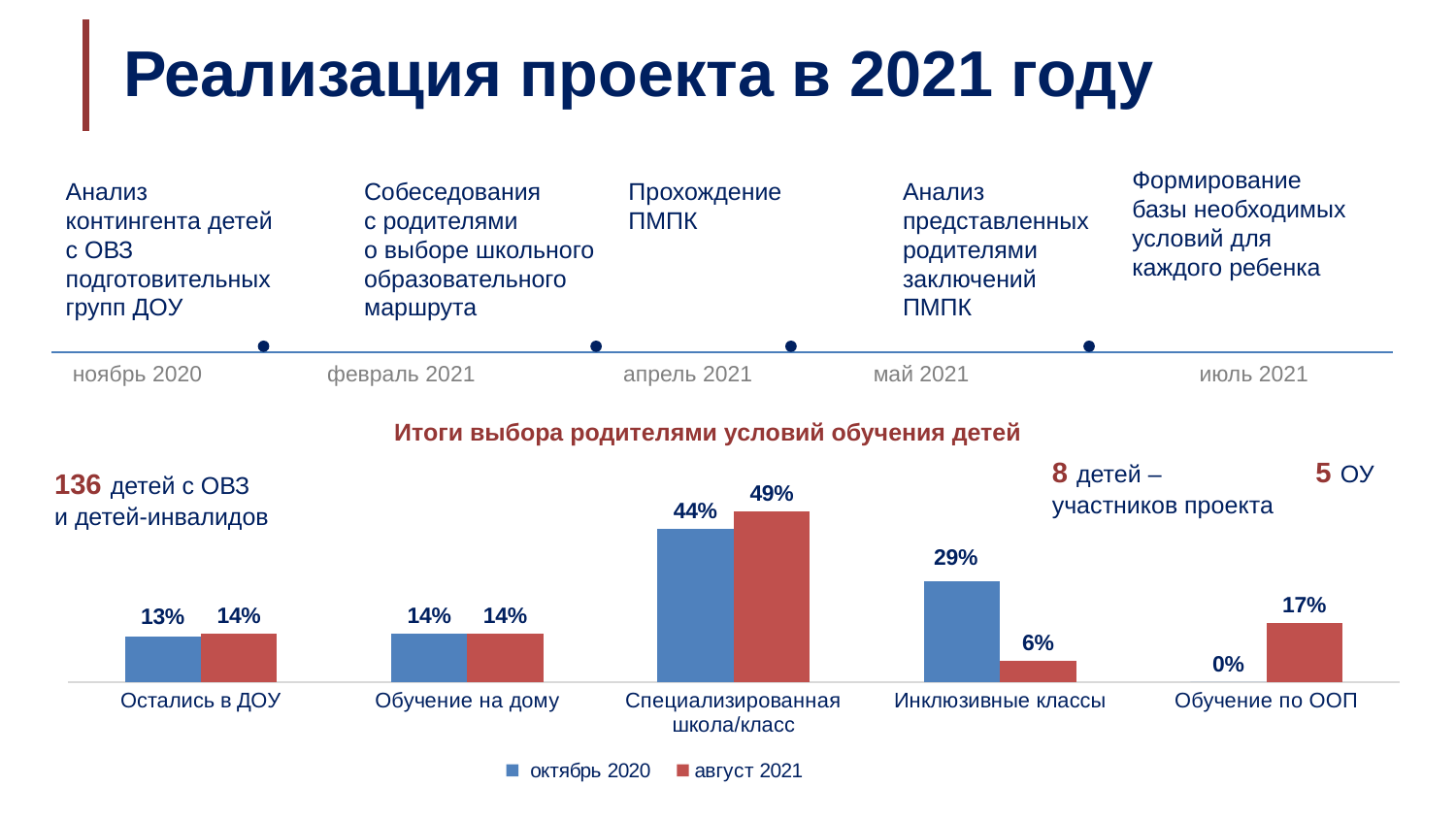
Which category has the highest value in the 'август 2021' series? Специализированная школа/класс What is the value for 'Специализированная школа/класс' in the 'август 2021' series? 49% What is the value for 'Инклюзивные классы' in the 'октябрь 2020' series? 29% What is the difference between the 'октябрь 2020' and 'август 2021' values for 'Инклюзивные классы'? 23% How many categories are shown on the x axis of the chart? 5 How many series does the legend list? 2 Which is larger for 'Специализированная школа/класс': the 'октябрь 2020' value or the 'август 2021' value? август 2021 What is the value for 'Обучение по ООП' in the 'октябрь 2020' series? 0% Which series is shown in red in the chart? август 2021 What kind of chart is shown on the slide? bar chart What is the title of the chart? Итоги выбора родителями условий обучения детей Which category has the lowest value in the 'октябрь 2020' series? Обучение по ООП